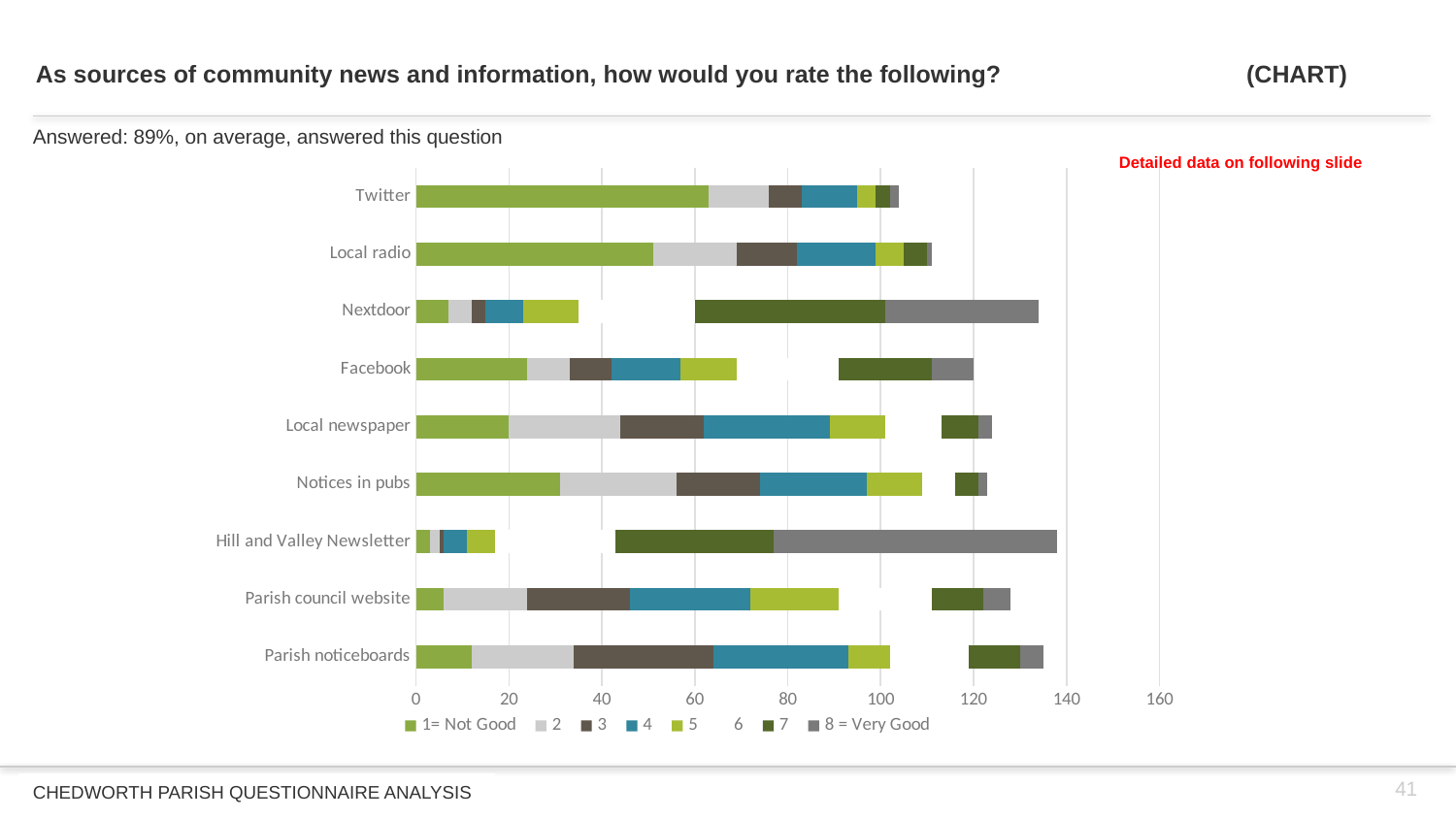
Is the total length of the Hill and Valley Newsletter bar greater or less than 120? greater What is the label of the last entry in the chart legend? 8 = Very Good What kind of chart is shown on the slide? Stacked bar chart Is the '1= Not Good' segment for Hill and Valley Newsletter greater or less than 20? less Which has the longer '1= Not Good' segment, Twitter or Parish council website? Twitter Which has the longer total bar, Hill and Valley Newsletter or Twitter? Hill and Valley Newsletter Is the total length of the Twitter bar greater or less than 120? less What is the label of the first entry in the chart legend? 1= Not Good How many categories (news sources) are plotted on the chart? 9 How many series does the chart legend list? 8